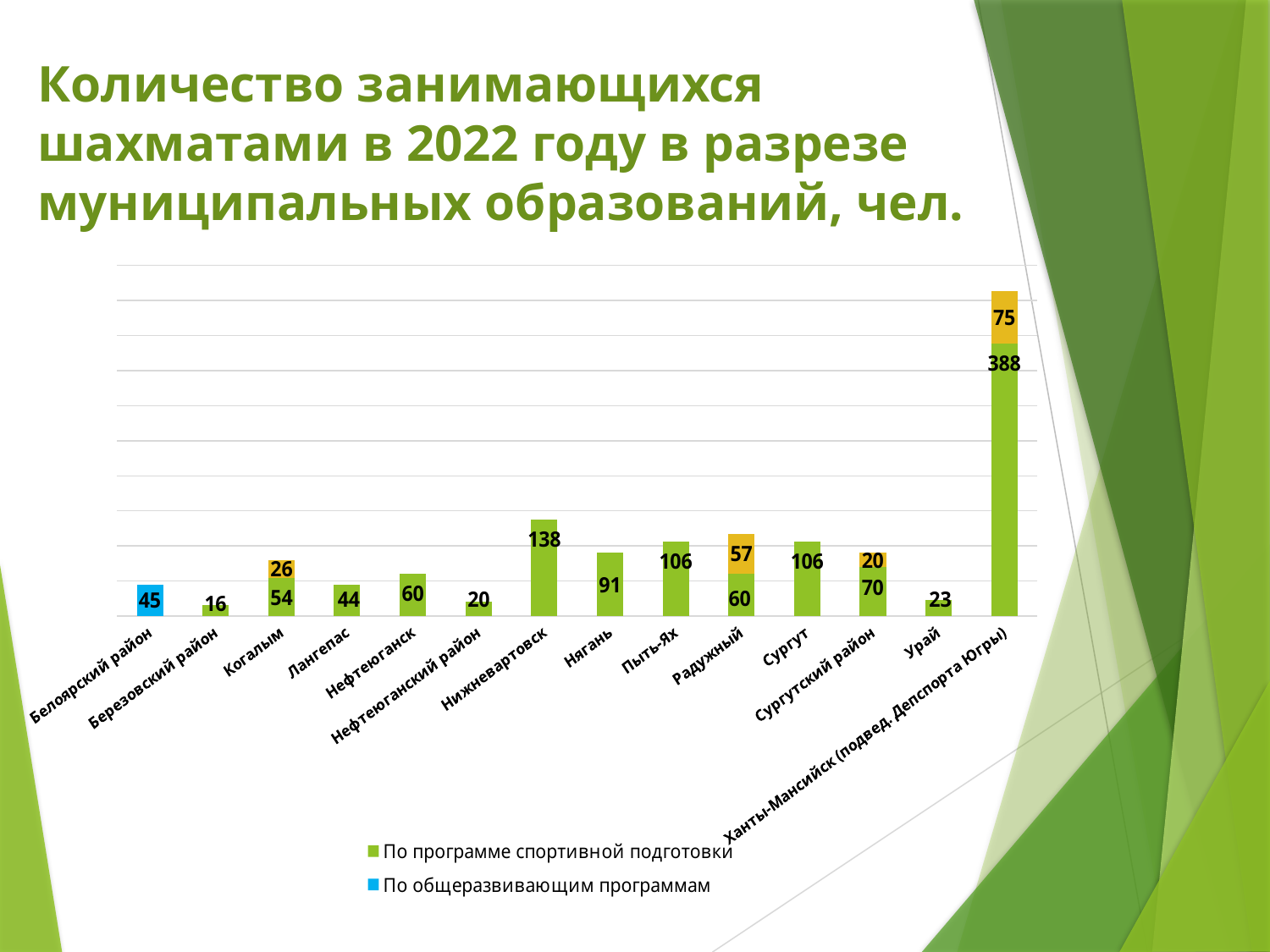
What is the value for Белоярский район? 45 What is the value for Нижневартовск? 138 What is the value of the green segment (По программе спортивной подготовки) for Ханты-Мансийск (подвед. Депспорта Югры)? 388 What kind of chart is shown on the slide? Bar chart Which is larger, the value for Нефтеюганск or the value for Лангепас? Нефтеюганск Which category has the lowest value? Березовский район What is the difference between the values for Нижневартовск and Нягань? 47 Which category has the tallest bar? Ханты-Мансийск (подвед. Депспорта Югры) What is the value of the yellow segment for Радужный? 57 What is the total of the stacked bar for Когалым? 80 How many categories are shown on the x axis? 14 What is the total of the stacked bar for Сургутский район? 90